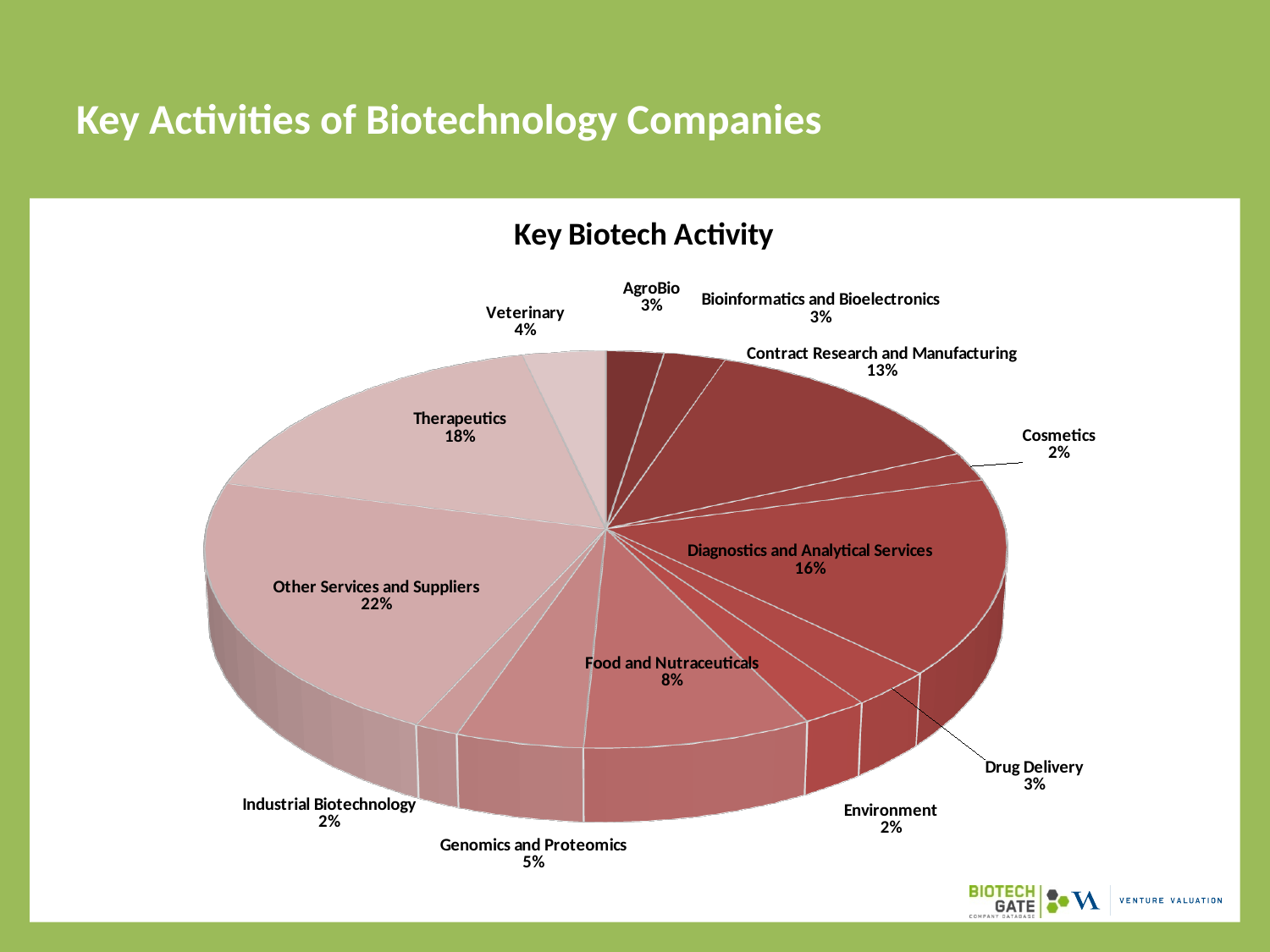
What is the value shown for Therapeutics? 18% How many categories are shown in the pie chart? 13 Which is larger, the share for Diagnostics and Analytical Services or the share for Contract Research and Manufacturing? Diagnostics and Analytical Services What share of the pie does Other Services and Suppliers hold? 22% What is the title of the chart? Key Biotech Activity What is the combined share of Veterinary and AgroBio? 7% What is the value shown for Genomics and Proteomics? 5% Which category has the largest slice of the pie? Other Services and Suppliers What kind of chart is shown on the slide? Pie chart What is the difference between the shares of Therapeutics and Food and Nutraceuticals? 10% What is the value shown for Diagnostics and Analytical Services? 16% What is the value shown for Contract Research and Manufacturing? 13%